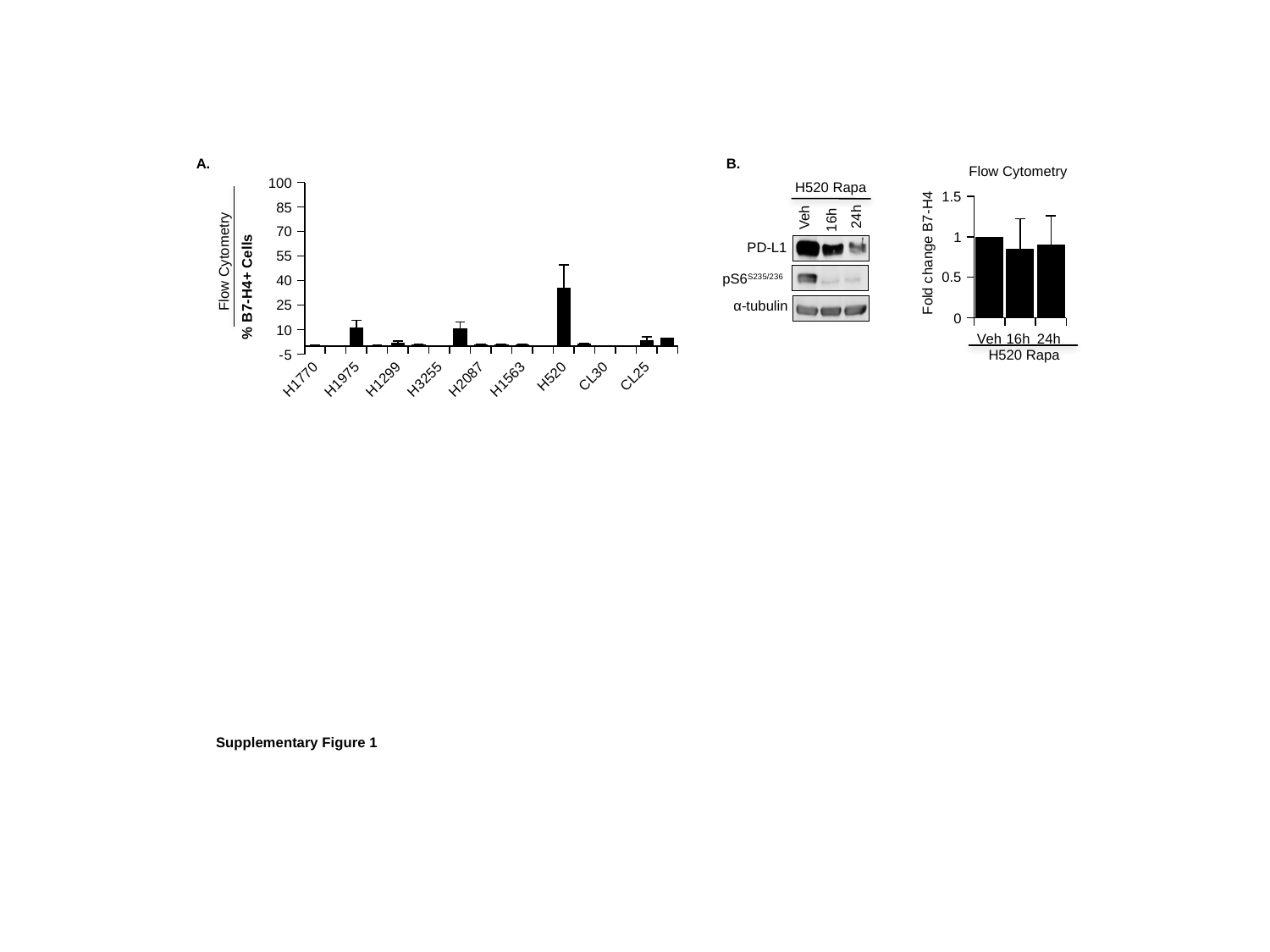
In the bar chart in panel B, how many conditions are shown on the x axis? 3 In the chart in panel A, what is the label of the y axis? % B7-H4+ Cells In the bar chart in panel B, what is the fold change B7-H4 value for Veh? 1 In the chart in panel A, which is larger, the value for H1975 or the value for H1299? H1975 In the bar chart in panel B, which is larger, the value for Veh or the value for 16h? Veh In the bar chart in panel B, is the value for 16h greater or less than 1? less What is the title of the bar chart in panel B? Flow Cytometry In the chart in panel A, which cell line has the highest % B7-H4+ Cells? H520 In the chart in panel A, what kind of chart is shown? bar chart In the chart in panel A, is the value for H1770 greater or less than 10? less In the chart in panel A, is the value for H520 greater or less than 25? greater